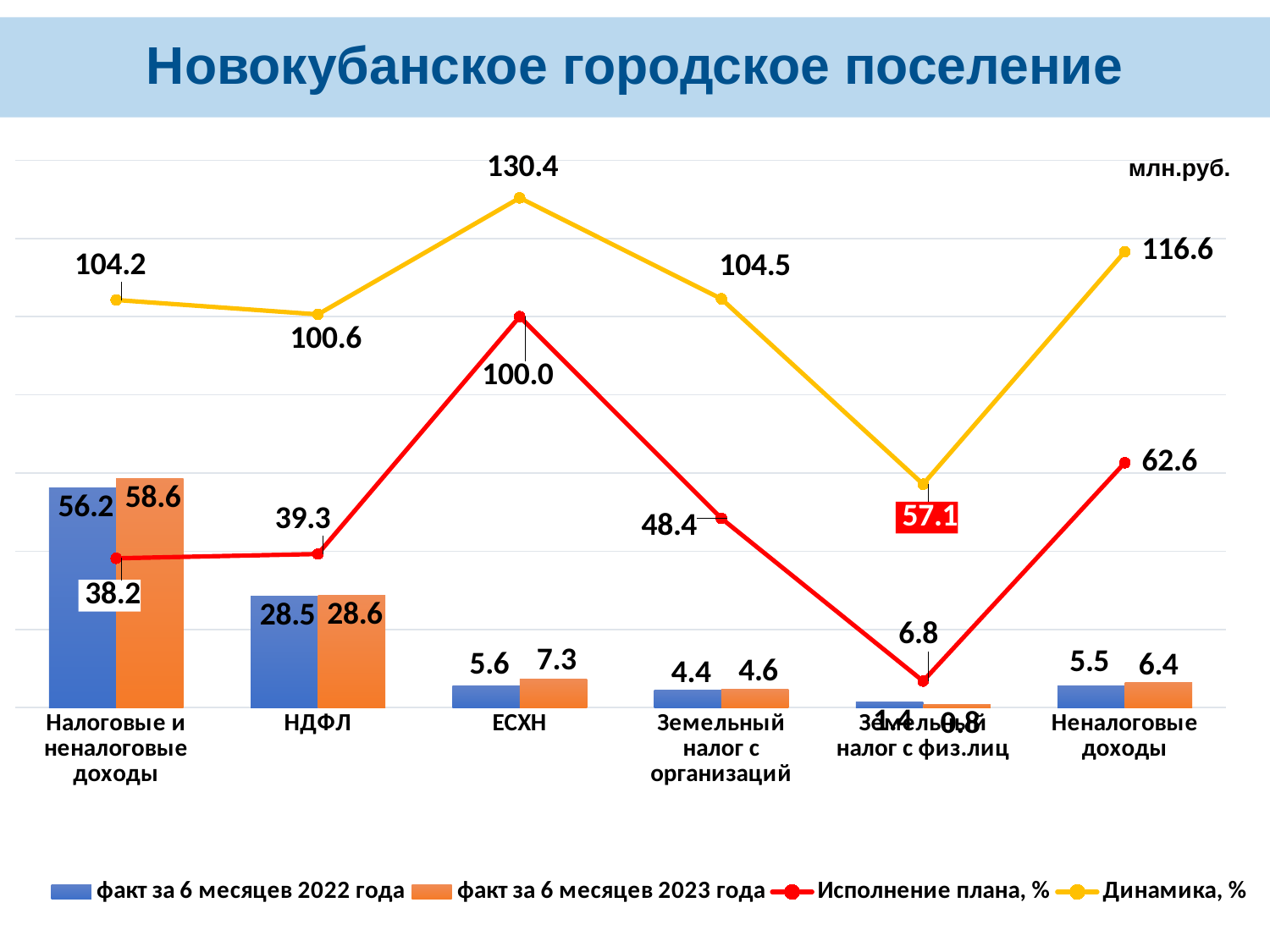
Which category has the lowest 'Исполнение плана, %' value? Земельный налог с физ.лиц What unit is indicated in the top right corner of the chart? млн.руб. What kind of chart is this? Combined bar and line chart What is the 'Исполнение плана, %' value for Неналоговые доходы? 62.6 What is the 'Динамика, %' value for ЕСХН? 130.4 What is the difference between the 2023 and 2022 values for ЕСХН? 1.7 How many categories are shown on the x axis? 6 Which is larger for Земельный налог с организаций: the 2022 value or the 2023 value? 2023 value (4.6) Which category has the highest 'Динамика, %' value? ЕСХН What is the value of 'факт за 6 месяцев 2022 года' for Налоговые и неналоговые доходы? 56.2 How many series does the legend list? 4 What is the value of 'факт за 6 месяцев 2023 года' for НДФЛ? 28.6